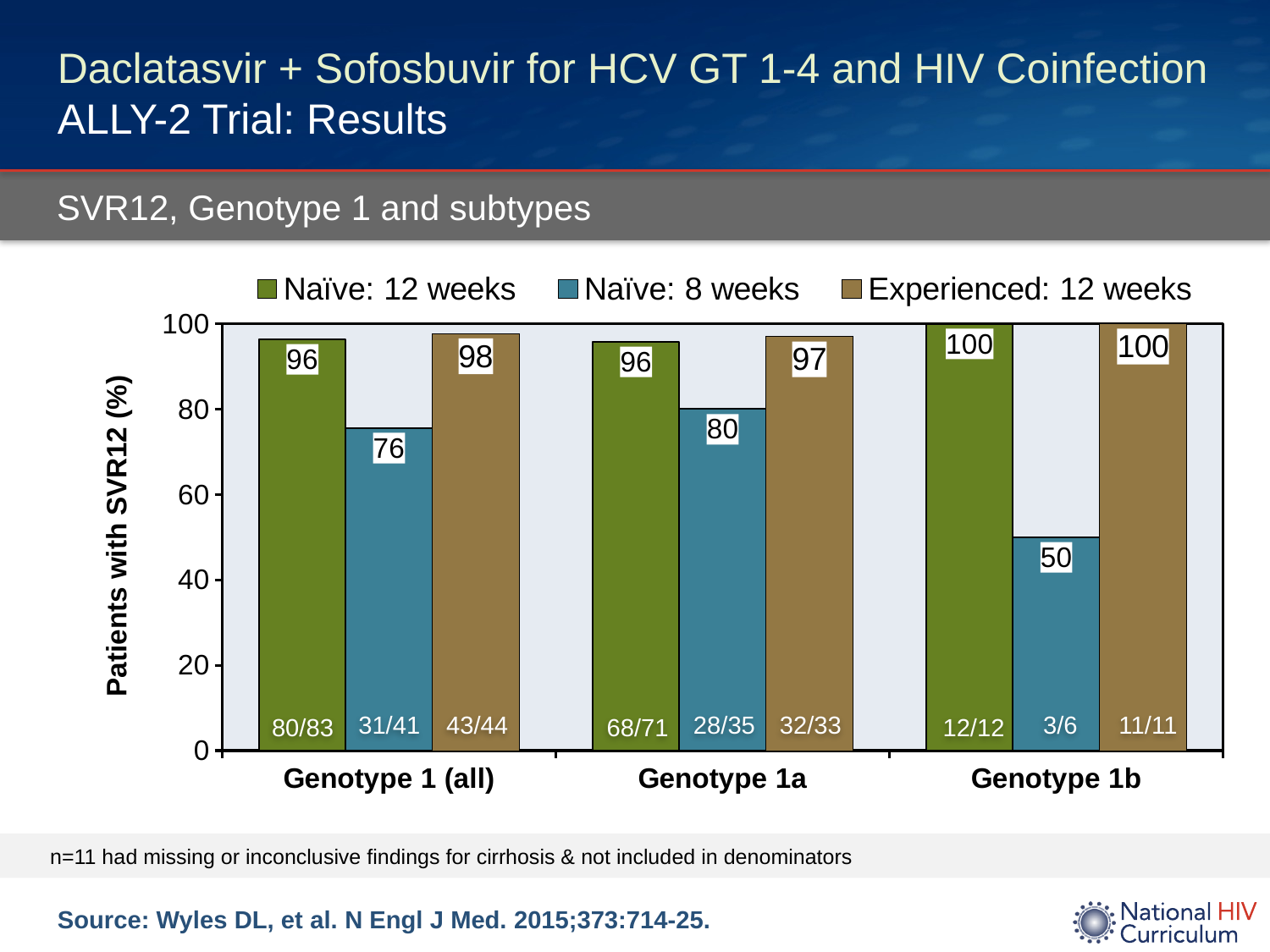
What is the SVR12 percentage for Naïve: 8 weeks in Genotype 1 (all)? 76 What is the SVR12 percentage for Experienced: 12 weeks in Genotype 1a? 97 What is the difference between the Naïve: 12 weeks and Naïve: 8 weeks SVR12 percentages in Genotype 1 (all)? 20 How many series does the legend list? 3 What is the SVR12 percentage for Naïve: 12 weeks in Genotype 1b? 100 Which genotype category has the lowest SVR12 value for Naïve: 8 weeks? Genotype 1b What is the label of the y axis? Patients with SVR12 (%) Within Genotype 1a, which series has the lowest SVR12 percentage? Naïve: 8 weeks What fraction of patients is shown for Naïve: 8 weeks in Genotype 1b? 3/6 Is the SVR12 percentage for Naïve: 8 weeks in Genotype 1a larger or smaller than for Experienced: 12 weeks in Genotype 1a? smaller What kind of chart is shown on the slide? bar chart How many genotype categories are shown on the x axis? 3